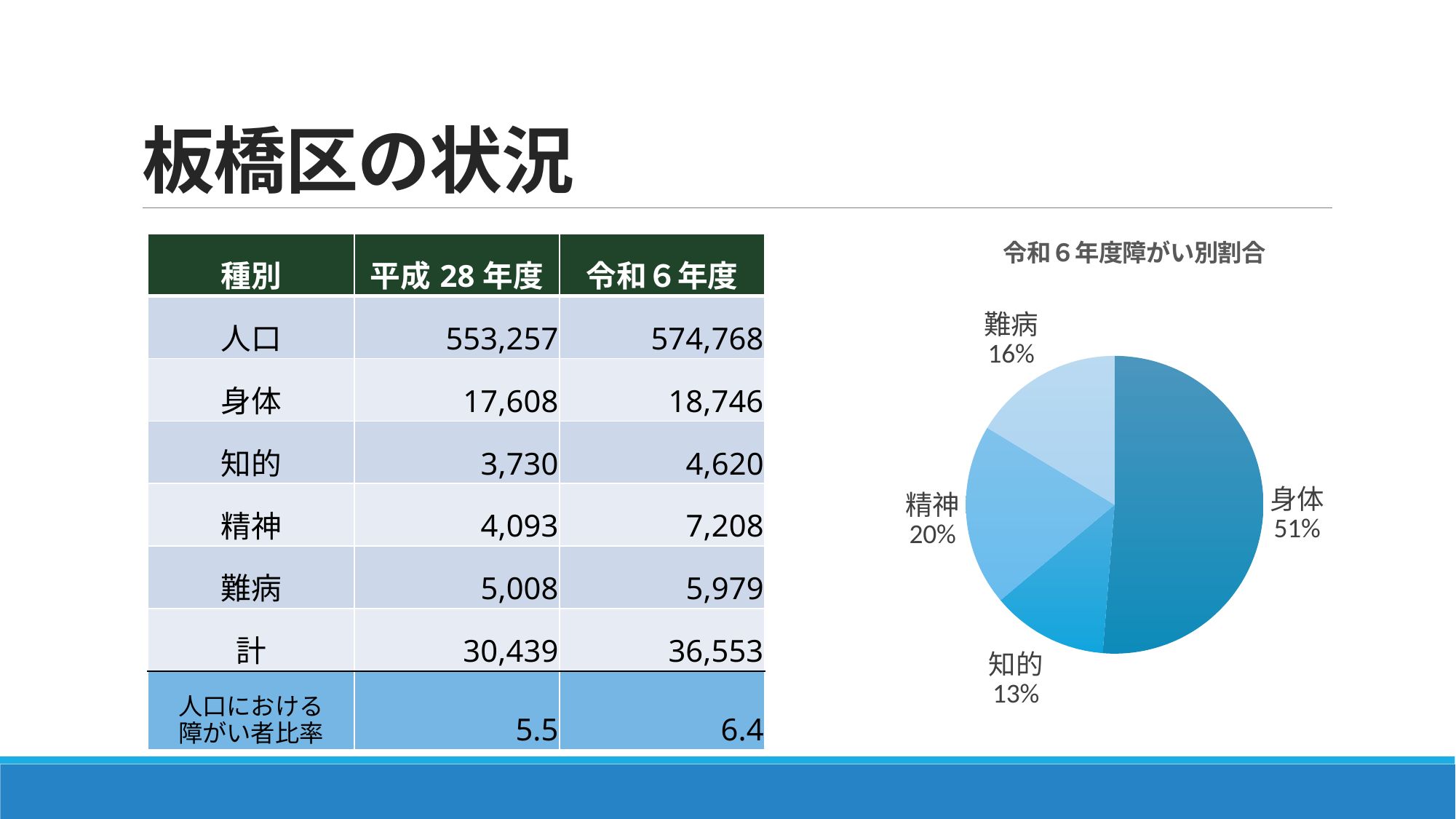
Which slice of the pie chart is the smallest? 知的 Which slice of the pie chart is the largest? 身体 What is the title of the pie chart? 令和６年度障がい別割合 In the pie chart, what share does 身体 have? 51% How many slices does the pie chart have? 4 In the pie chart, what share does 知的 have? 13% What kind of chart is shown on the slide? Pie chart In the pie chart, what is the difference in percentage points between 身体 and 精神? 31 In the pie chart, which is larger, 難病 or 知的? 難病 In the pie chart, what share does 精神 have? 20% In the pie chart, what is the difference in percentage points between 精神 and 難病? 4